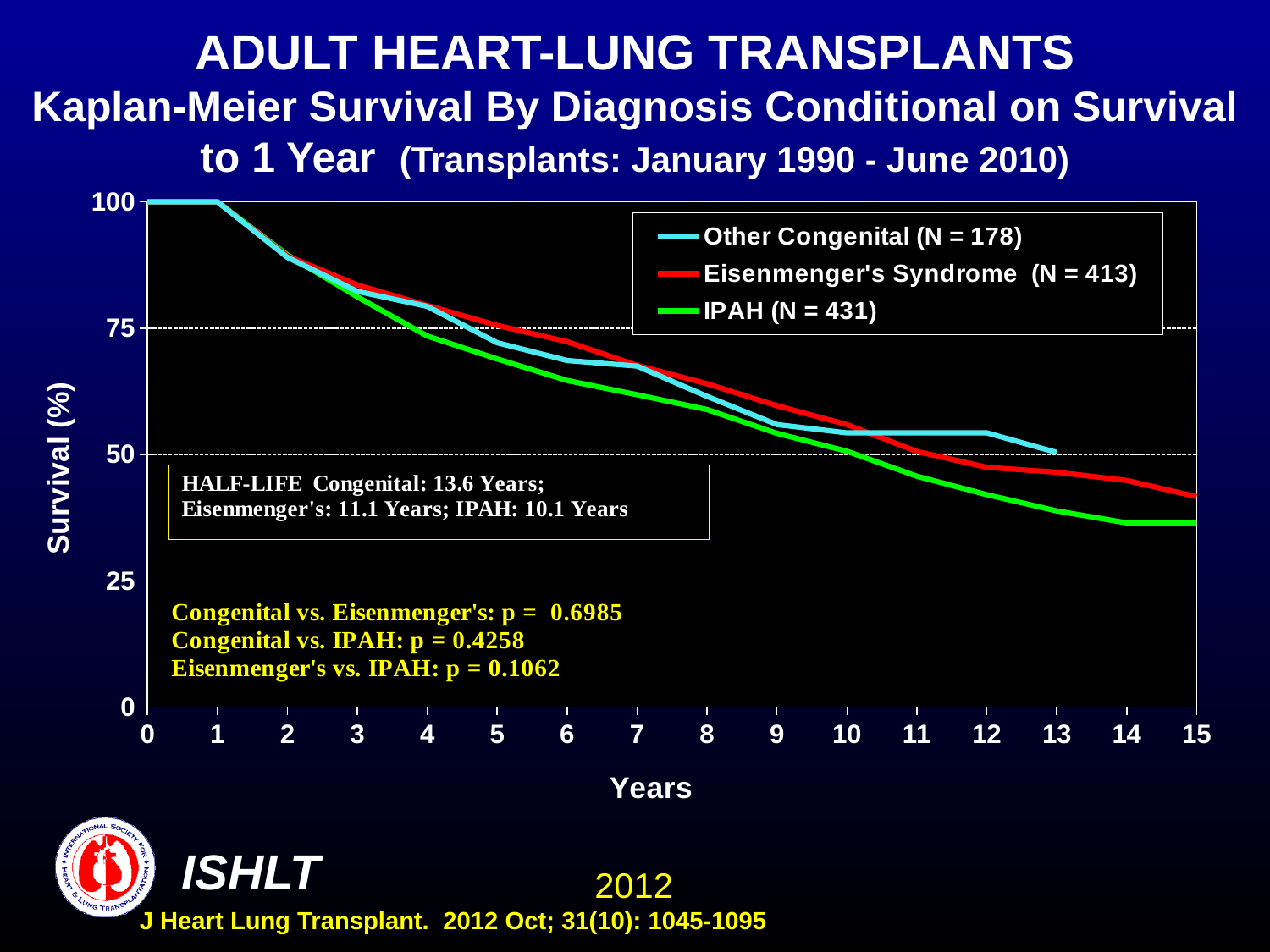
Is the survival value for Other Congenital at 3 years greater or less than 75? greater What is the number of patients (N) for the Eisenmenger's Syndrome group? 413 How many series does the legend list? 3 What kind of chart is shown on the slide? line chart Which diagnosis group has the longest half-life? Congenital What is the half-life reported for the IPAH group? 10.1 Years What is the half-life reported for the Congenital group? 13.6 Years At 15 years, which curve shows higher survival: Eisenmenger's Syndrome or IPAH? Eisenmenger's Syndrome What is the number of patients (N) for the IPAH group? 431 Which diagnosis group has the shortest half-life? IPAH Do the survival curves rise or fall as years increase? fall Is the survival value for IPAH at 15 years greater or less than 50? less